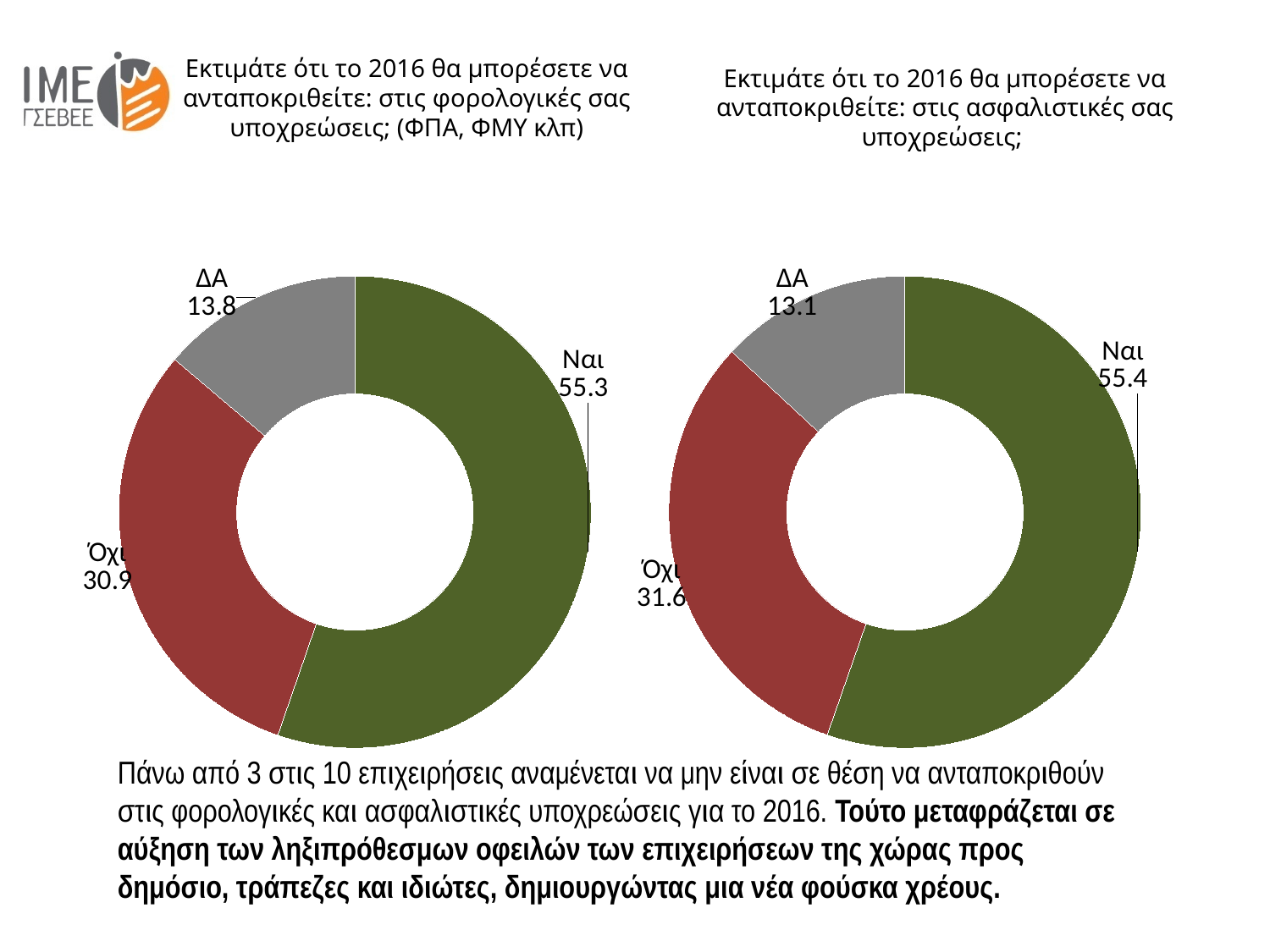
In the right chart (insurance obligations), which category has the smallest slice? ΔΑ In the right chart (insurance obligations), what is the value for ΔΑ? 13.1 In the left chart (tax obligations), which category has the largest slice? Ναι What colour is the Ναι slice in both charts? Green In the left chart (tax obligations), what is the value for Όχι? 30.9 Which is larger: the Όχι value in the left chart or the Όχι value in the right chart? Right chart (31.6) In the left chart (tax obligations), what is the value for Ναι? 55.3 How many categories does the left chart (tax obligations) show? 3 In the left chart (tax obligations), what is the difference between the Ναι and Όχι values? 24.4 In the right chart (insurance obligations), what is the difference between the Όχι and ΔΑ values? 18.5 In the right chart (insurance obligations), what is the value for Όχι? 31.6 What type of chart is used on this slide? Doughnut chart